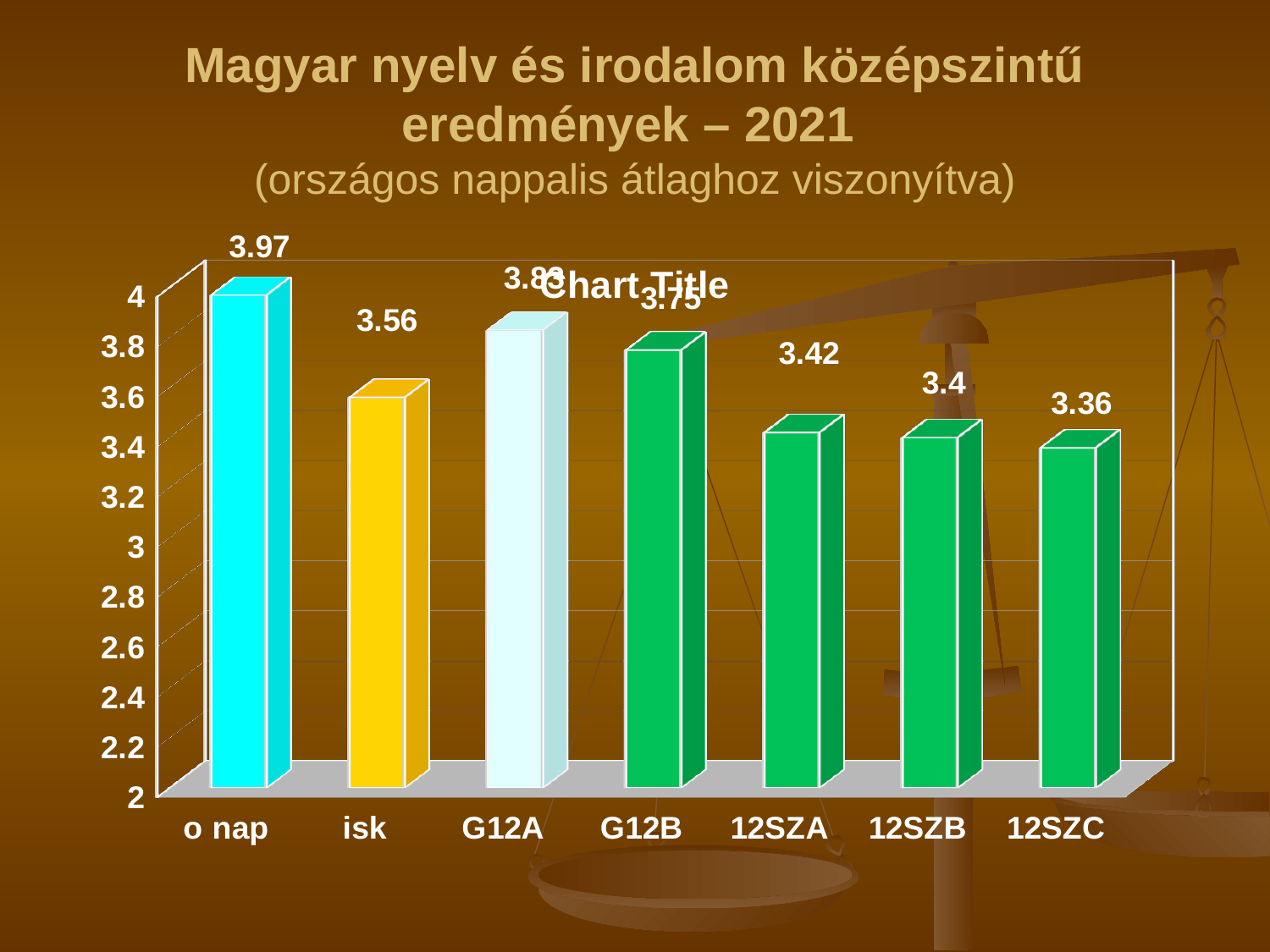
Which category has the lowest value? 12SZC Is the value for 12SZB greater or less than 3.6? less Which category has the highest value? o nap What is the value for 12SZA? 3.42 How many categories are shown on the x axis? 7 What is the difference between the values for o nap and isk? 0.41 What is the value for isk? 3.56 What is the difference between the values for G12B and 12SZC? 0.39 What is the value for o nap? 3.97 What is the value for 12SZC? 3.36 Which is larger, the value for isk or the value for G12B? G12B What kind of chart is shown on the slide? bar chart